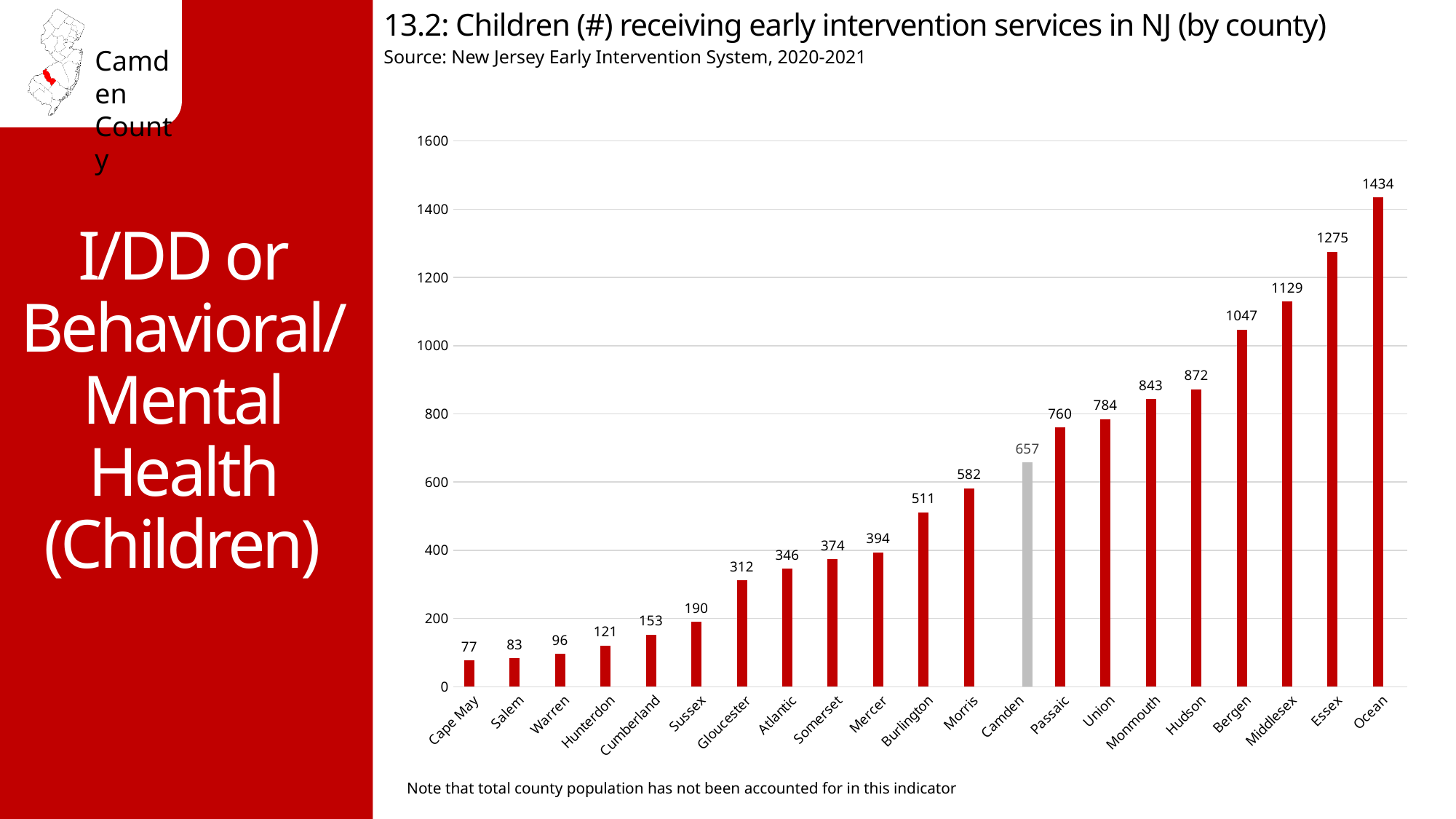
What is the difference between the values for Camden and Morris? 75 How many children received early intervention services in Camden county? 657 What kind of chart is shown on the slide? Bar chart Is the value for Hudson greater or less than 800? greater Which county has the lowest number of children receiving early intervention services? Cape May How many counties are shown on the chart? 21 Do the values rise or fall moving from left to right along the x axis? Rise Which county has a larger value, Passaic or Union? Union What is the difference between the values for Ocean and Essex? 159 Which county has the highest number of children receiving early intervention services? Ocean Which county's bar is coloured grey instead of red? Camden What is the value shown for Bergen county? 1047